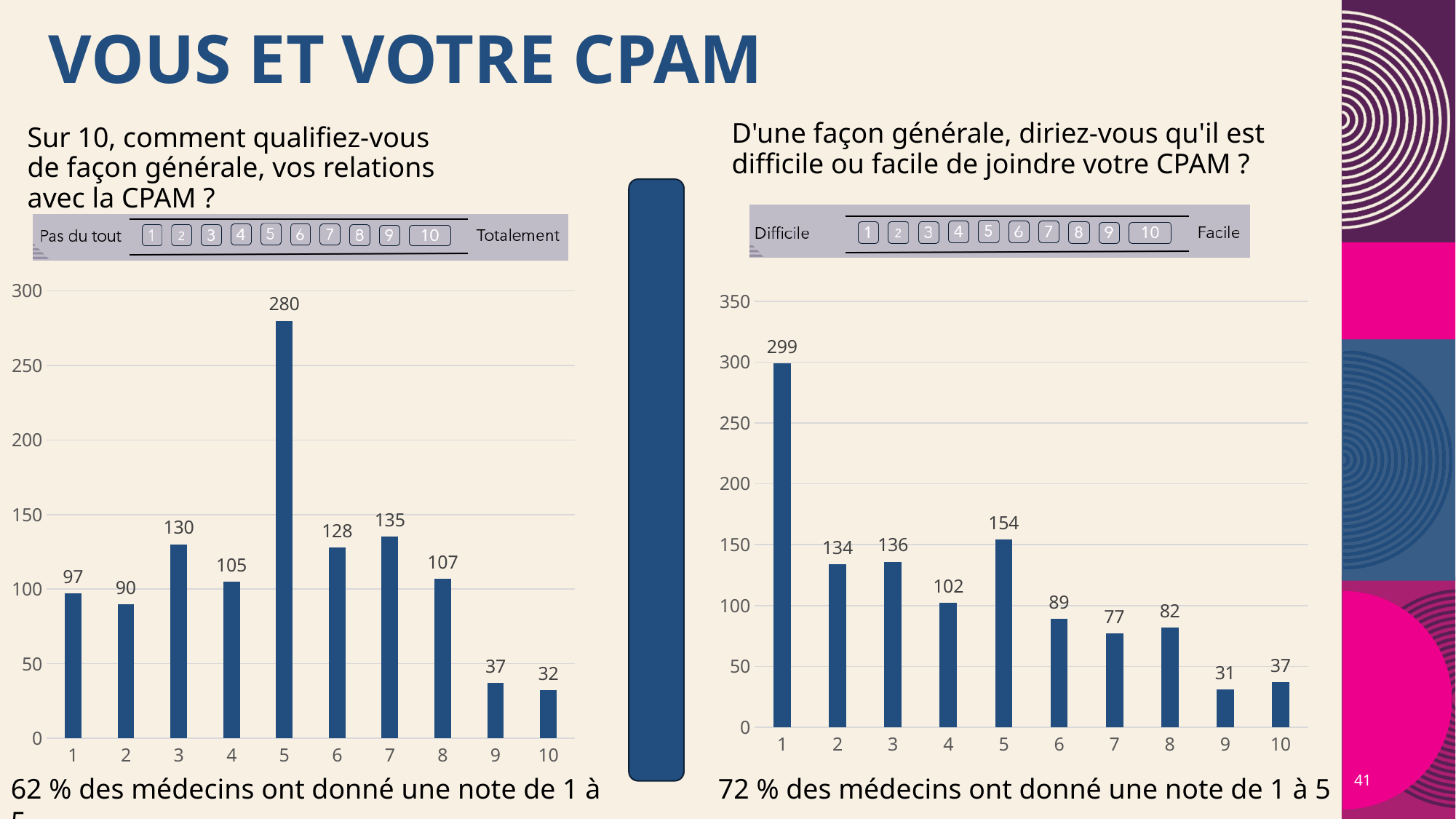
In the left chart (relations with the CPAM), how many rating categories are shown on the x axis? 10 In the left chart (relations with the CPAM), what is the value for rating 5? 280 In the left chart (relations with the CPAM), which rating has the highest value? 5 In the right chart (ease of reaching the CPAM), which is larger: the value for rating 2 or rating 3? Rating 3 In the left chart (relations with the CPAM), is the value for rating 3 greater or less than 100? greater In the left chart (relations with the CPAM), what is the value for rating 10? 32 In the left chart (relations with the CPAM), what is the difference between the values for rating 5 and rating 6? 152 In the right chart (ease of reaching the CPAM), which rating has the lowest value? 9 In the right chart (ease of reaching the CPAM), what is the value for rating 1? 299 In the right chart (ease of reaching the CPAM), what is the difference between the values for rating 1 and rating 5? 145 In the right chart (ease of reaching the CPAM), what is the value for rating 7? 77 What type of chart is the right chart (ease of reaching the CPAM)? Bar chart